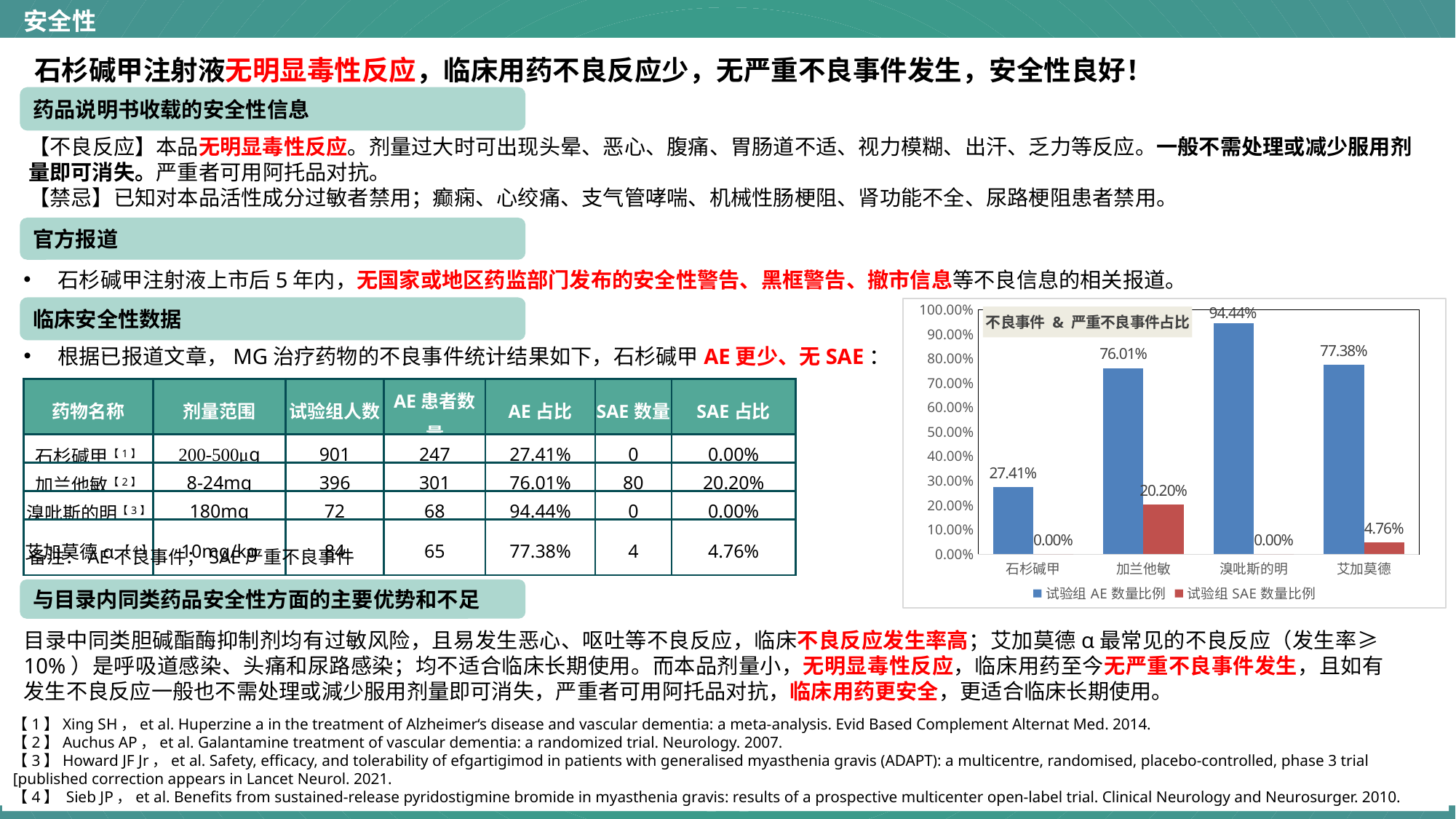
What kind of chart is shown on the slide? bar chart What is the 试验组 SAE 数量比例 value for 加兰他敏 in the chart? 20.20% Which is larger in the chart: the 试验组 AE 数量比例 for 加兰他敏 or for 艾加莫德? 艾加莫德 Which drug has the highest 试验组 SAE 数量比例 in the chart? 加兰他敏 Which drug has the lowest 试验组 AE 数量比例 in the chart? 石杉碱甲 What is the 试验组 AE 数量比例 value for 艾加莫德 in the chart? 77.38% How many series does the chart legend list? 2 Which drug has the highest 试验组 AE 数量比例 in the chart? 溴吡斯的明 What is the difference between the 试验组 AE 数量比例 of 溴吡斯的明 and 石杉碱甲 in the chart? 67.03% How many drug categories are shown on the x axis of the chart? 4 What is the 试验组 AE 数量比例 value for 石杉碱甲 in the chart? 27.41% What is the title of the chart on the slide? 不良事件 & 严重不良事件占比